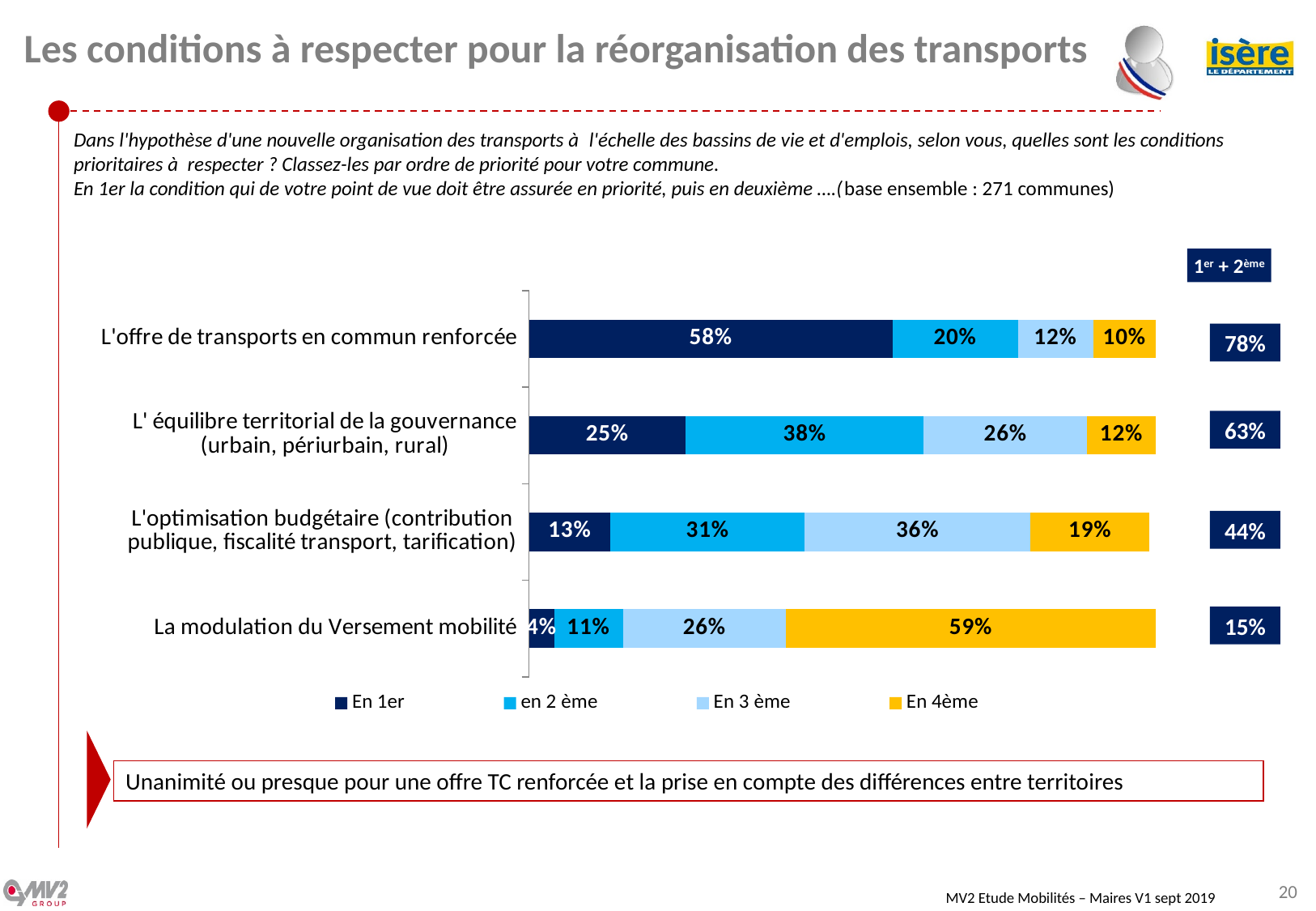
How many categories (conditions) are plotted in the chart? 4 What is the 'En 1er' value for 'L'offre de transports en commun renforcée'? 58% What is the difference between the 'En 1er' values for 'L'offre de transports en commun renforcée' and 'L' équilibre territorial de la gouvernance'? 33% Which is larger: the 'En 4ème' value for 'L'optimisation budgétaire' or the 'En 4ème' value for 'L' équilibre territorial de la gouvernance'? L'optimisation budgétaire What is the '1er + 2ème' value shown for 'L'optimisation budgétaire (contribution publique, fiscalité transport, tarification)'? 44% Which category has the highest 'En 1er' value? L'offre de transports en commun renforcée How many series does the legend list? 4 What is the 'En 4ème' value for 'La modulation du Versement mobilité'? 59% What is the 'en 2 ème' value for 'L' équilibre territorial de la gouvernance (urbain, périurbain, rural)'? 38% What kind of chart is shown on the slide? Stacked bar chart Which category has the lowest 'En 1er' value? La modulation du Versement mobilité What is the 'En 3 ème' value for 'L'optimisation budgétaire (contribution publique, fiscalité transport, tarification)'? 36%